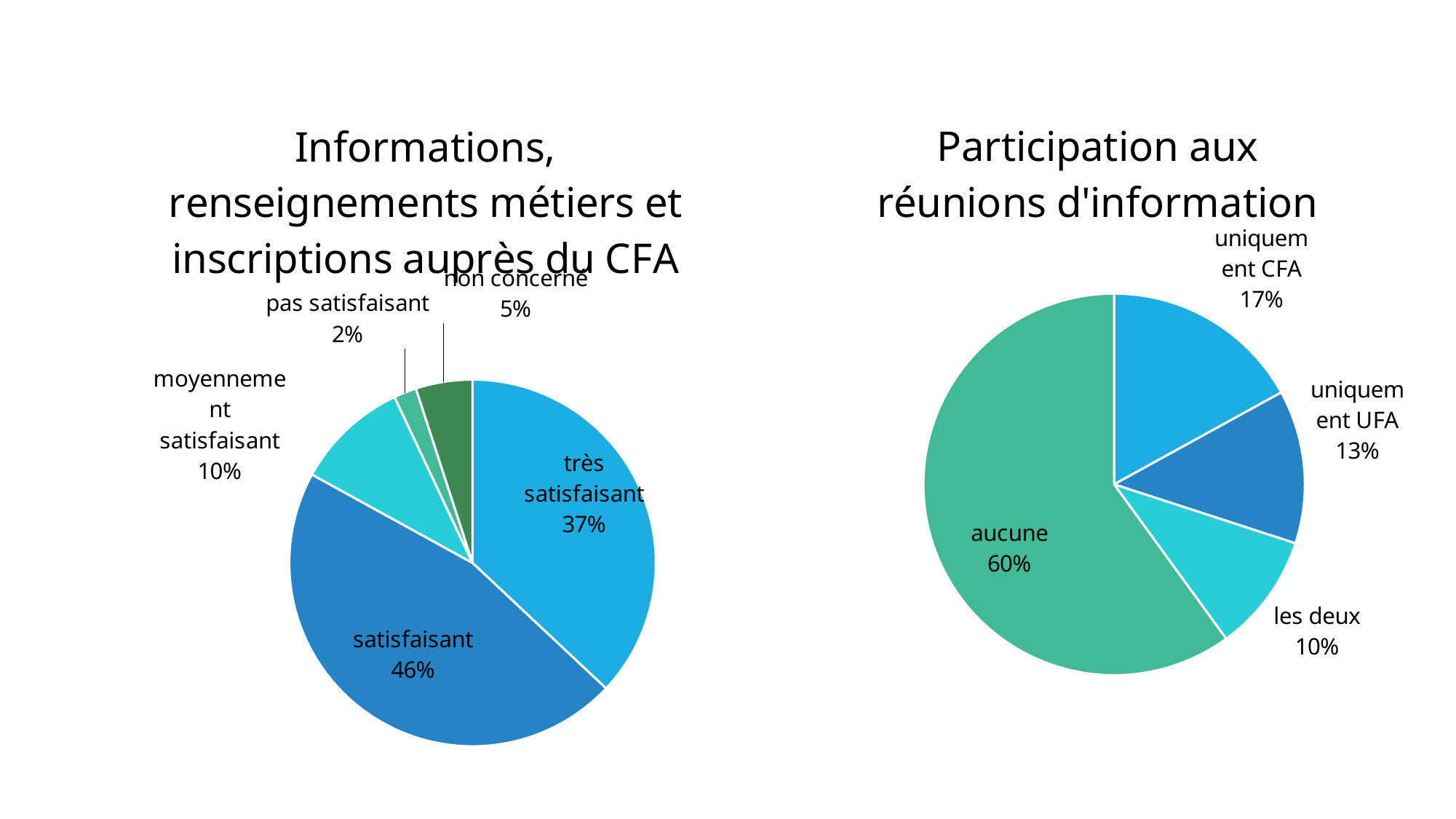
In the left pie chart (Informations, renseignements métiers et inscriptions auprès du CFA), which category has the smallest slice? pas satisfaisant In the right pie chart (Participation aux réunions d'information), what share is labelled for 'uniquement UFA'? 13% In the right pie chart (Participation aux réunions d'information), which is larger, 'uniquement CFA' or 'les deux'? uniquement CFA What is the title of the chart on the right side of the slide? Participation aux réunions d'information In the left pie chart (Informations, renseignements métiers et inscriptions auprès du CFA), how many slices are there? 5 In the left pie chart (Informations, renseignements métiers et inscriptions auprès du CFA), what share is labelled for 'très satisfaisant'? 37% In the right pie chart (Participation aux réunions d'information), how many categories are shown? 4 In the left pie chart (Informations, renseignements métiers et inscriptions auprès du CFA), what is the difference between 'satisfaisant' and 'très satisfaisant'? 9 percentage points What type of chart is used on the right side of the slide (Participation aux réunions d'information)? pie chart In the left pie chart (Informations, renseignements métiers et inscriptions auprès du CFA), what share is labelled for 'satisfaisant'? 46% In the left pie chart (Informations, renseignements métiers et inscriptions auprès du CFA), which category has the largest slice? satisfaisant In the right pie chart (Participation aux réunions d'information), what share is labelled for 'aucune'? 60%